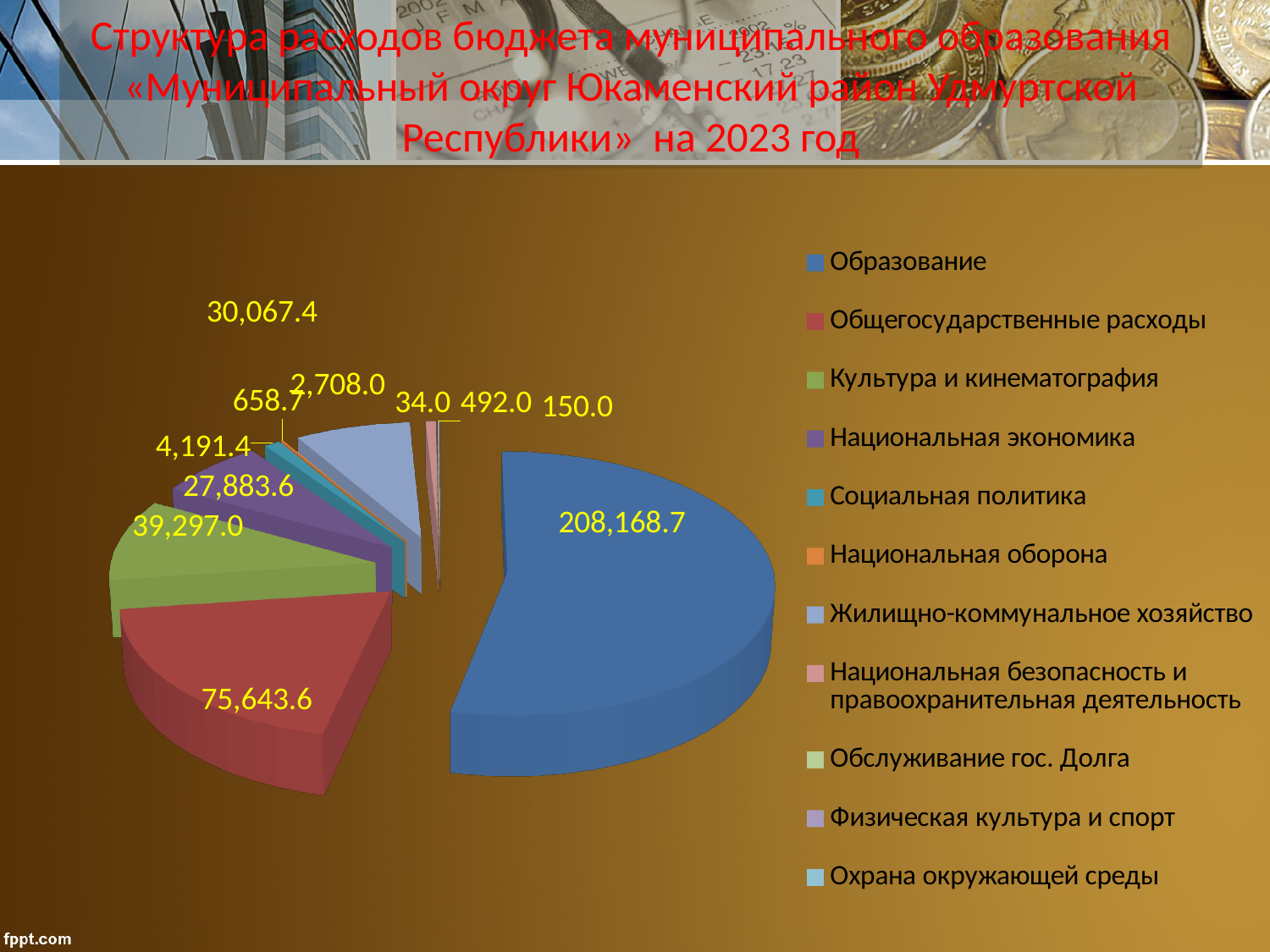
Which is larger, the value for Культура и кинематография or the value for Национальная экономика? Культура и кинематография Which colour represents Образование in the pie chart? blue Which category has the largest slice of the pie? Образование What is the value shown for Образование? 208,168.7 What is the smallest value labelled on the pie chart? 34.0 What is the difference between the values for Образование and Общегосударственные расходы? 132,525.1 What kind of chart is shown on the slide? pie chart What is the value shown for Общегосударственные расходы? 75,643.6 How many categories does the legend list? 11 What is the value shown for Культура и кинематография? 39,297.0 What is the value shown for Национальная экономика? 27,883.6 For which year does the slide title say the budget expenditure structure is shown? 2023